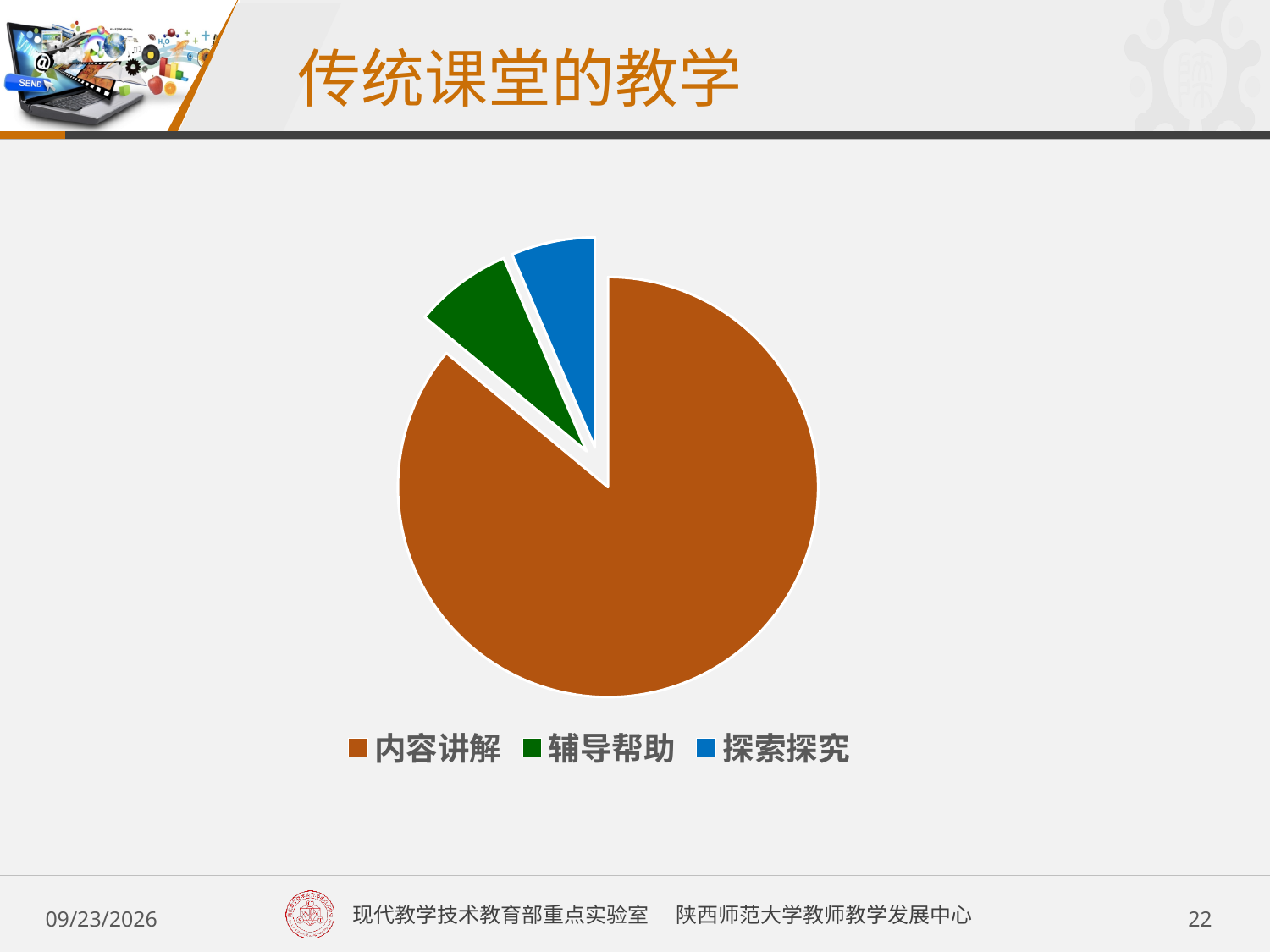
Which category has the smallest slice in the pie chart? 探索探究 Which category is shown in blue in the pie chart? 探索探究 Which slice is larger, 内容讲解 or 辅导帮助? 内容讲解 Which slice is larger, 辅导帮助 or 探索探究? 辅导帮助 What colour is the 辅导帮助 slice in the pie chart? green What kind of chart is shown on the slide? pie chart How many slices does the pie chart have? 3 Which category has the largest slice in the pie chart? 内容讲解 How many entries does the legend of the pie chart list? 3